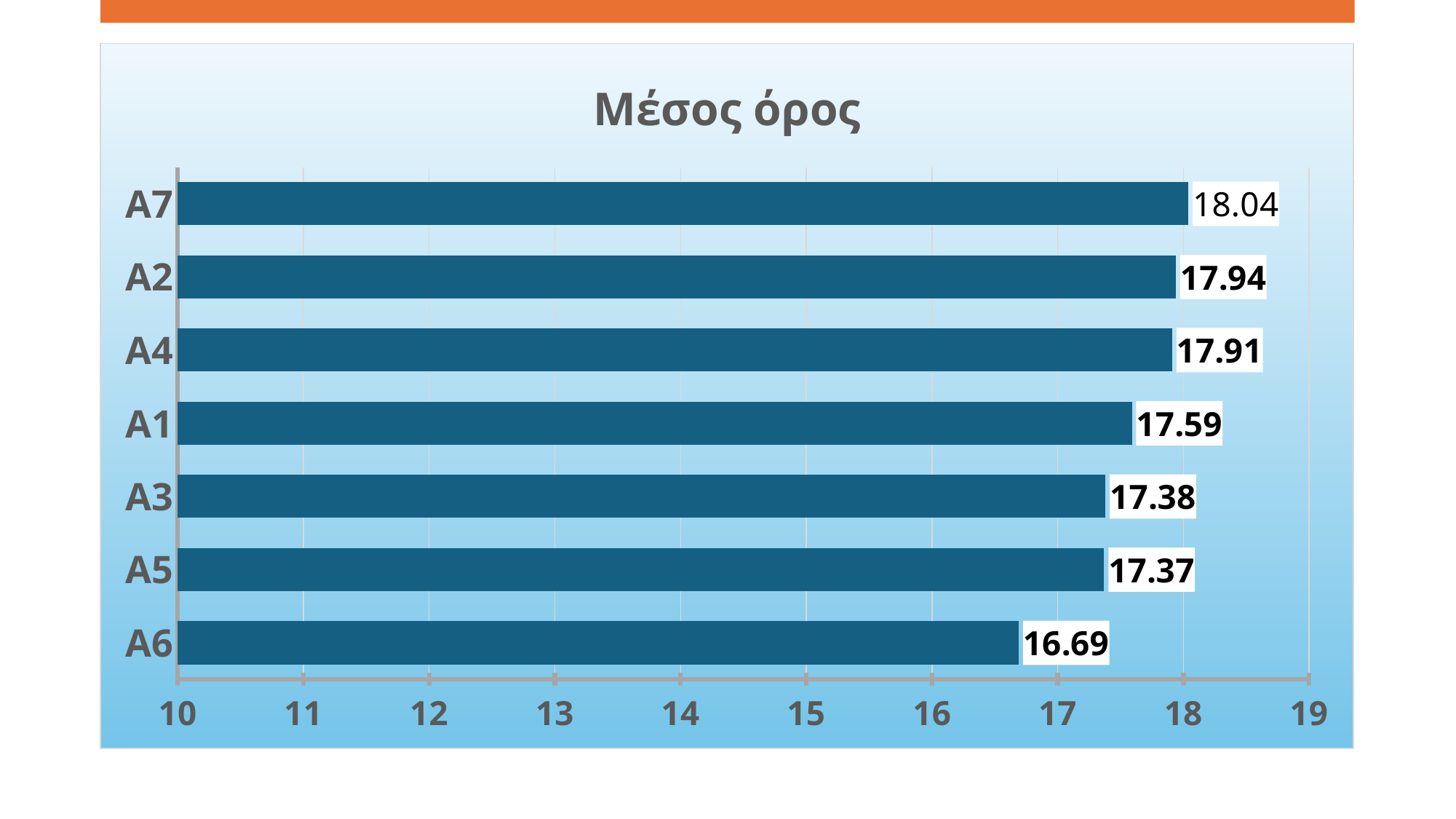
What is the value for A1? 17.59 How many categories are shown in the chart? 7 What kind of chart is shown on the slide? bar chart Is the value for A6 greater or less than 17? less What is the value for A7? 18.04 What is the title of the chart? Μέσος όρος What is the difference between the values for A2 and A1? 0.35 Which category has the lowest value? A6 What is the difference between the values for A7 and A6? 1.35 Which is larger, the value for A1 or the value for A3? A1 Which category has the highest value? A7 What is the value for A6? 16.69